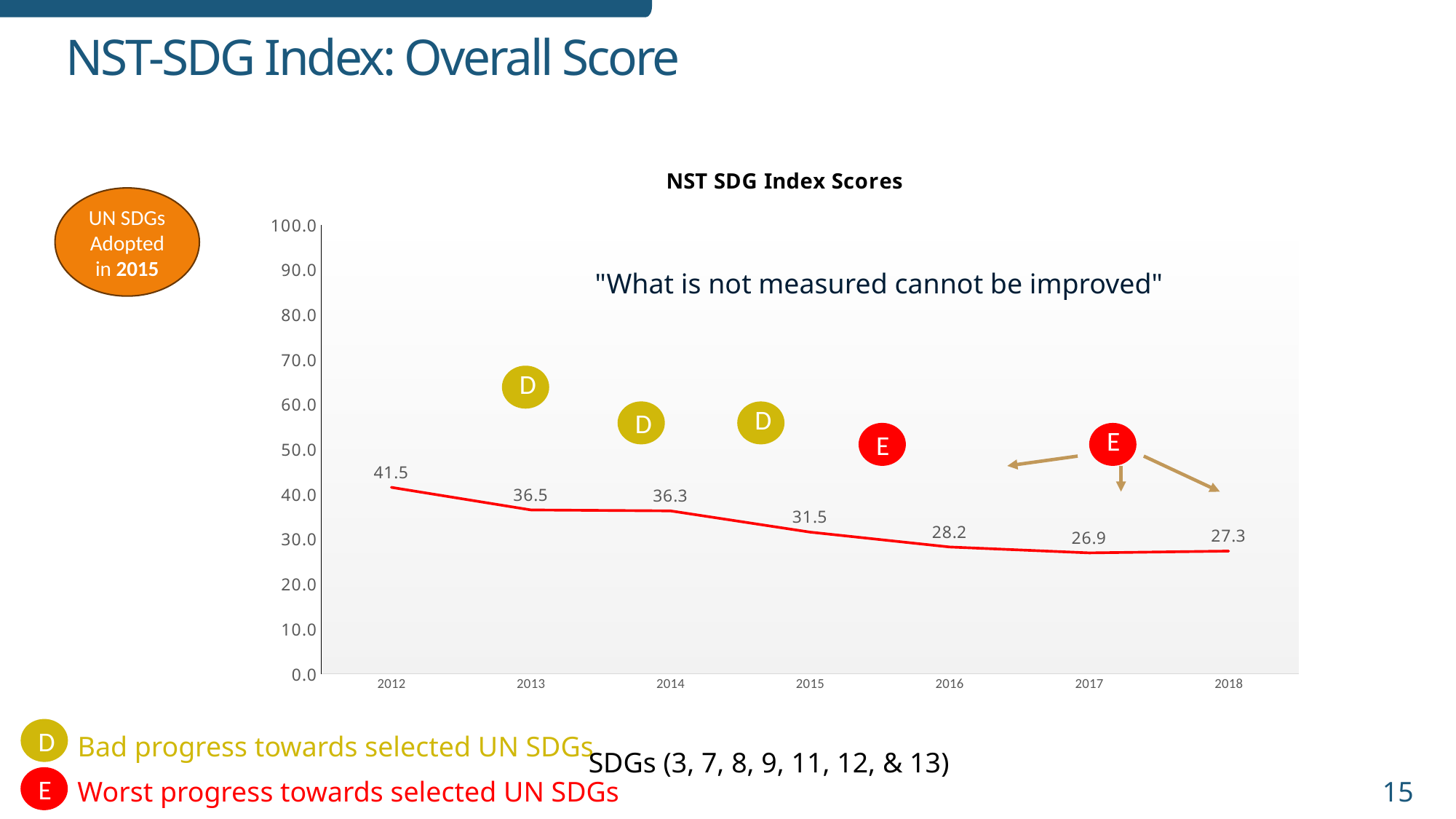
What is the difference between the 2012 score and the 2018 score? 14.2 Which year has the lowest NST SDG Index score? 2017 What is the NST SDG Index score for 2012? 41.5 Is the value for 2014 greater or less than 40.0? less What is the NST SDG Index score for 2015? 31.5 Which year has a higher score, 2016 or 2017? 2016 What is the NST SDG Index score for 2018? 27.3 How many years are plotted on the x axis? 7 What kind of chart is shown on the slide? line chart What is the title of the chart? NST SDG Index Scores Which year has the highest NST SDG Index score? 2012 What is the difference between the 2013 score and the 2014 score? 0.2